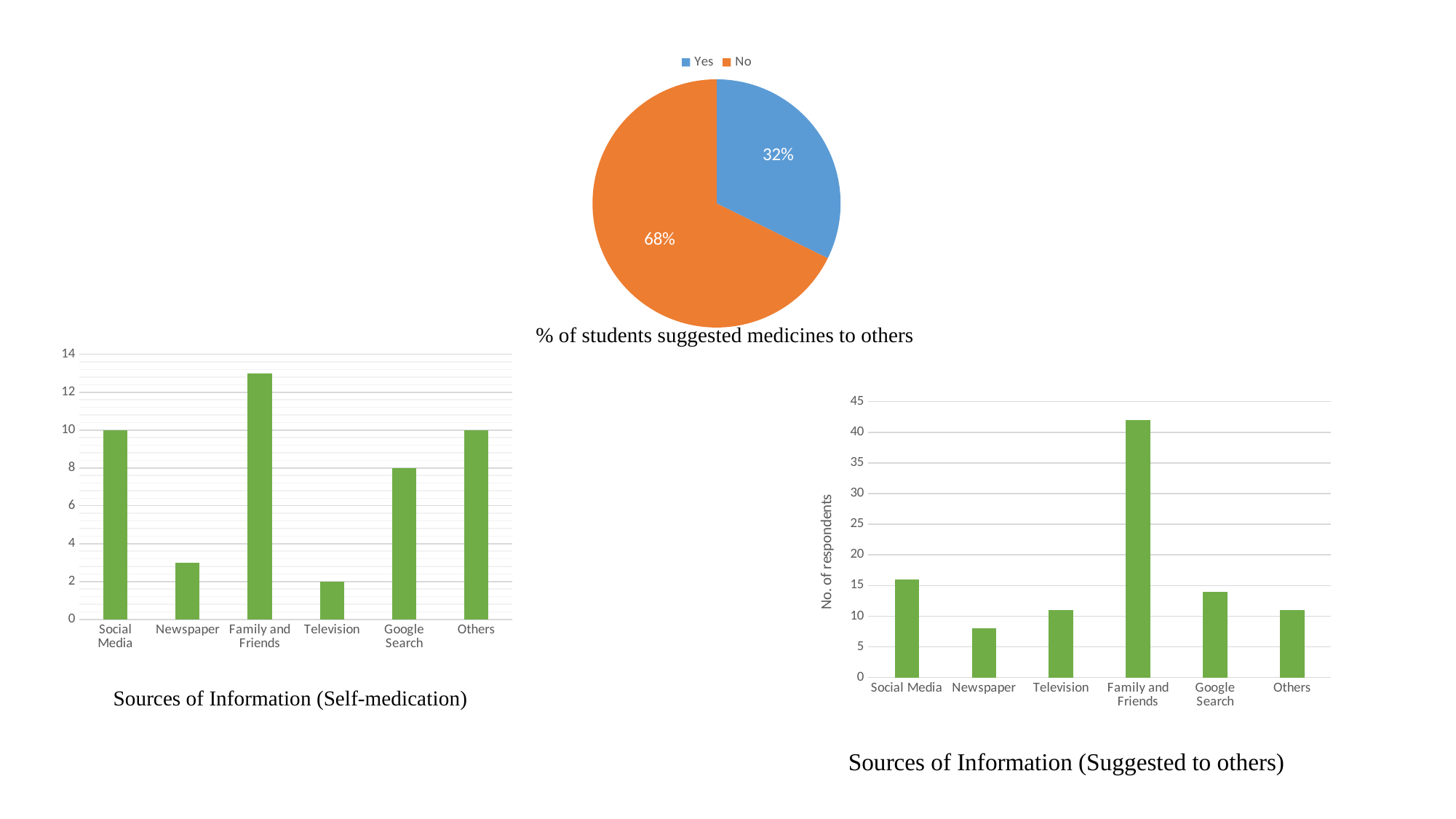
What kind of chart is '% of students suggested medicines to others'? Pie chart In the pie chart '% of students suggested medicines to others', what percentage answered No? 68% How many entries does the legend of the pie chart '% of students suggested medicines to others' list? 2 In the chart 'Sources of Information (Suggested to others)', which is larger, Social Media or Google Search? Social Media In the chart 'Sources of Information (Suggested to others)', is the value for Family and Friends greater or less than 40? greater In the chart 'Sources of Information (Self-medication)', which source has the highest value? Family and Friends In the chart 'Sources of Information (Self-medication)', what is the value for Television? 2 In the chart 'Sources of Information (Self-medication)', is the value for Family and Friends greater or less than 12? greater In the pie chart '% of students suggested medicines to others', what percentage answered Yes? 32% In the chart 'Sources of Information (Self-medication)', how many categories are shown on the x axis? 6 In the chart 'Sources of Information (Suggested to others)', which source has the lowest number of respondents? Newspaper In the chart 'Sources of Information (Self-medication)', what is the value for Google Search? 8